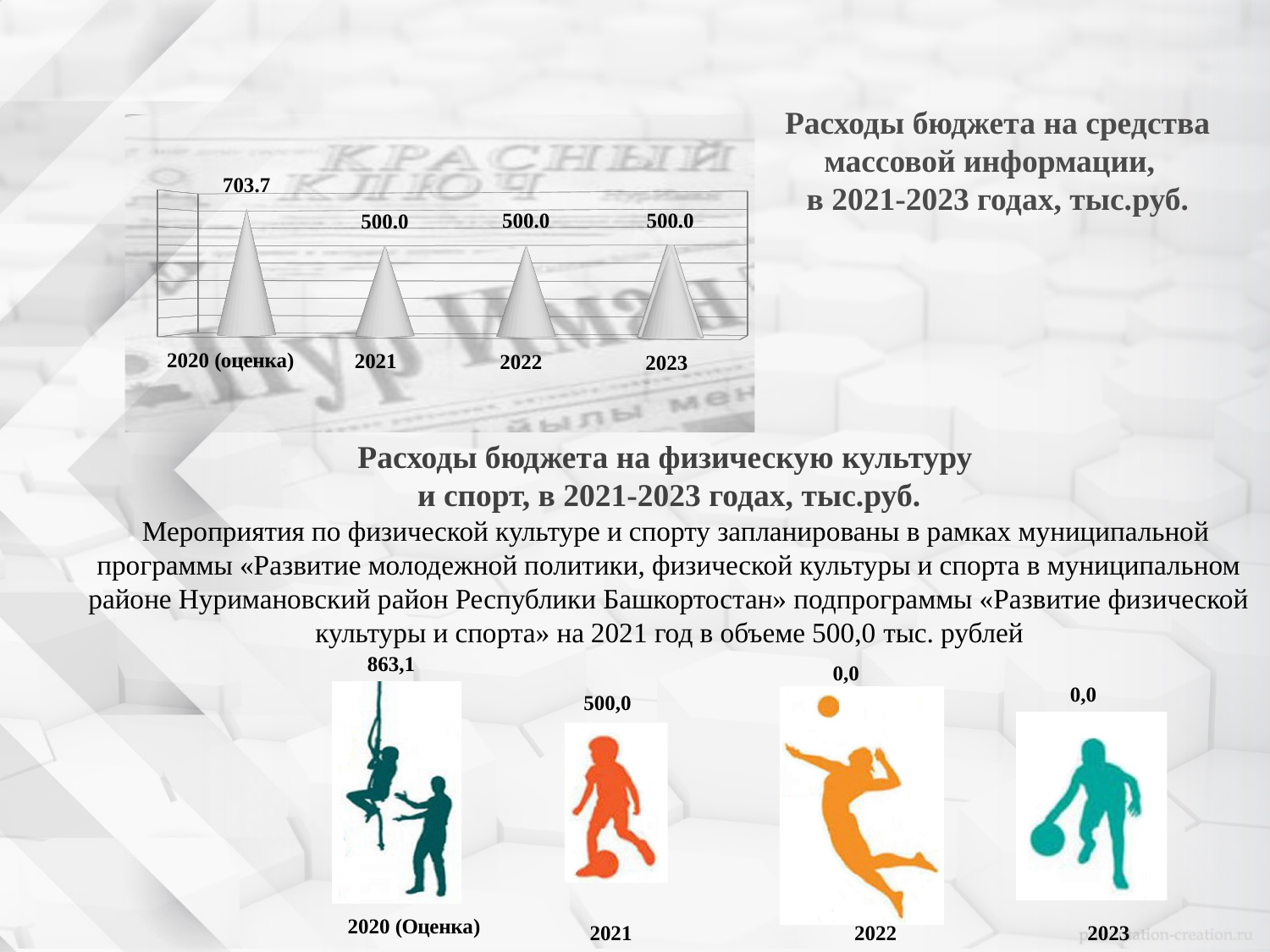
In the chart 'Расходы бюджета на средства массовой информации', do the values rise or fall from 2020 (оценка) to 2021? fall In the chart 'Расходы бюджета на средства массовой информации', how many categories are shown on the x axis? 4 In the lower chart 'Расходы бюджета на физическую культуру и спорт', what is the value for 2023? 0,0 In the chart 'Расходы бюджета на средства массовой информации', what is the difference between the values for 2020 (оценка) and 2021? 203.7 What kind of chart is 'Расходы бюджета на средства массовой информации'? bar chart In the chart 'Расходы бюджета на средства массовой информации', what is the value for 2022? 500.0 In the lower chart 'Расходы бюджета на физическую культуру и спорт', what is the value for 2020 (Оценка)? 863,1 In the lower chart 'Расходы бюджета на физическую культуру и спорт', what is the difference between the values for 2020 (Оценка) and 2021? 363,1 In the chart 'Расходы бюджета на средства массовой информации', is the value for 2021 larger or smaller than the value for 2020 (оценка)? smaller In the lower chart 'Расходы бюджета на физическую культуру и спорт', what is the value for 2021? 500,0 In the chart 'Расходы бюджета на средства массовой информации', what is the value for 2020 (оценка)? 703.7 In the chart 'Расходы бюджета на средства массовой информации', which category has the highest value? 2020 (оценка)